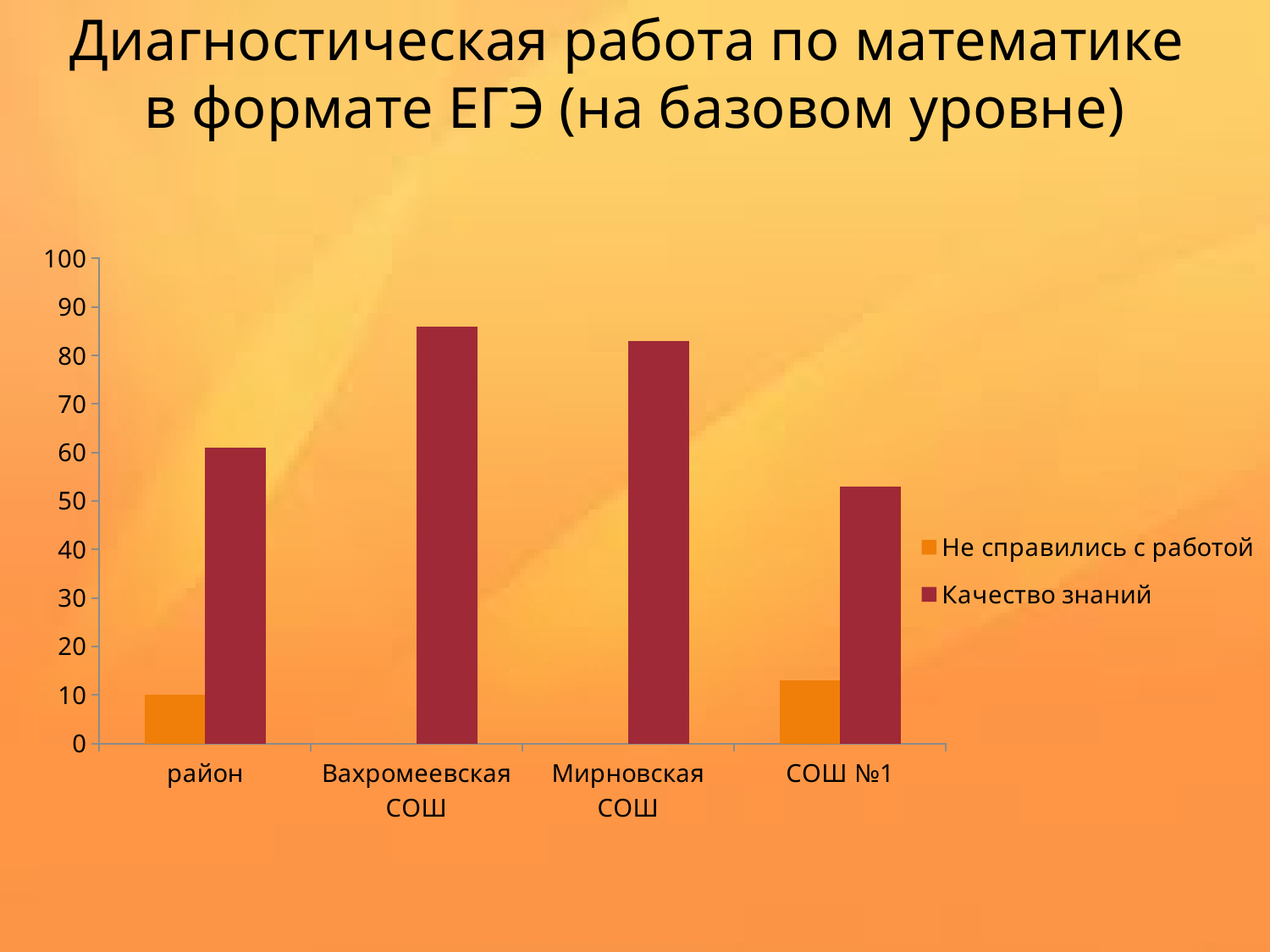
Which category has the highest value for Качество знаний? Вахромеевская СОШ Is the value of Не справились с работой for СОШ №1 greater or less than 20? less Which category has the lowest value for Качество знаний? СОШ №1 Is the value of Качество знаний for СОШ №1 greater or less than 60? less How many categories are shown on the x axis of the chart? 4 How many series does the chart's legend list? 2 What are the two series named in the chart's legend? Не справились с работой; Качество знаний What kind of chart is shown on the slide? bar chart Is the value of Качество знаний for район greater or less than 50? greater Which is larger: Качество знаний for Мирновская СОШ or for СОШ №1? Мирновская СОШ Which category has the highest value for Не справились с работой? СОШ №1